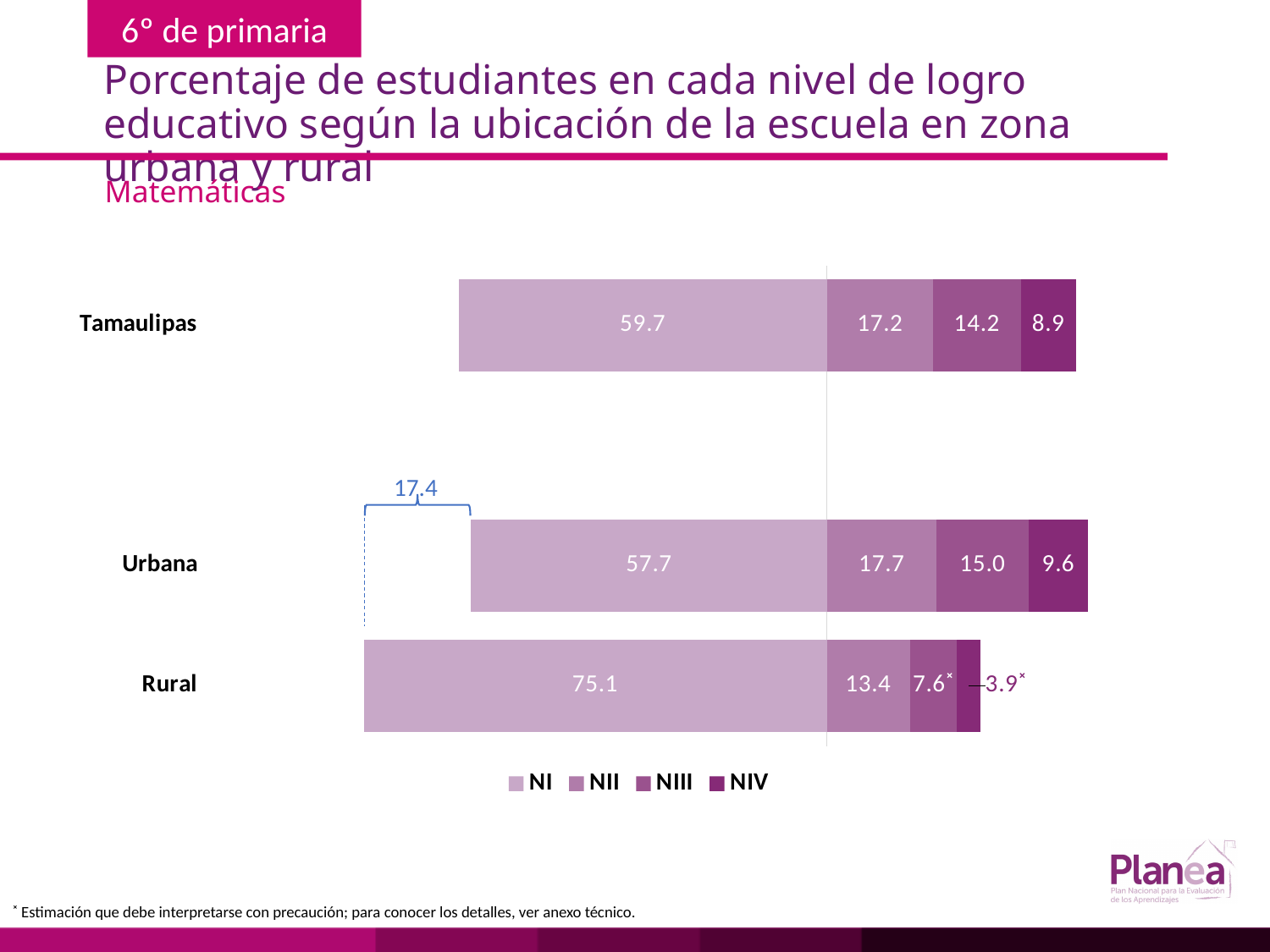
Which category has the lowest NIV value? Rural What is the difference between the NI values for Rural and Urbana? 17.4 Which category has the highest NI value? Rural How many categories are shown on the chart? 3 How many series does the legend list? 4 What is the total of the stacked bar for Tamaulipas? 100.0 What kind of chart is shown on the slide? Stacked bar chart What is the NII value for Tamaulipas? 17.2 What is the NIV value for Urbana? 9.6 Which is larger, the NIII value for Urbana or the NIII value for Tamaulipas? Urbana What is the NIII value for Rural? 7.6 What is the NI value for Rural? 75.1